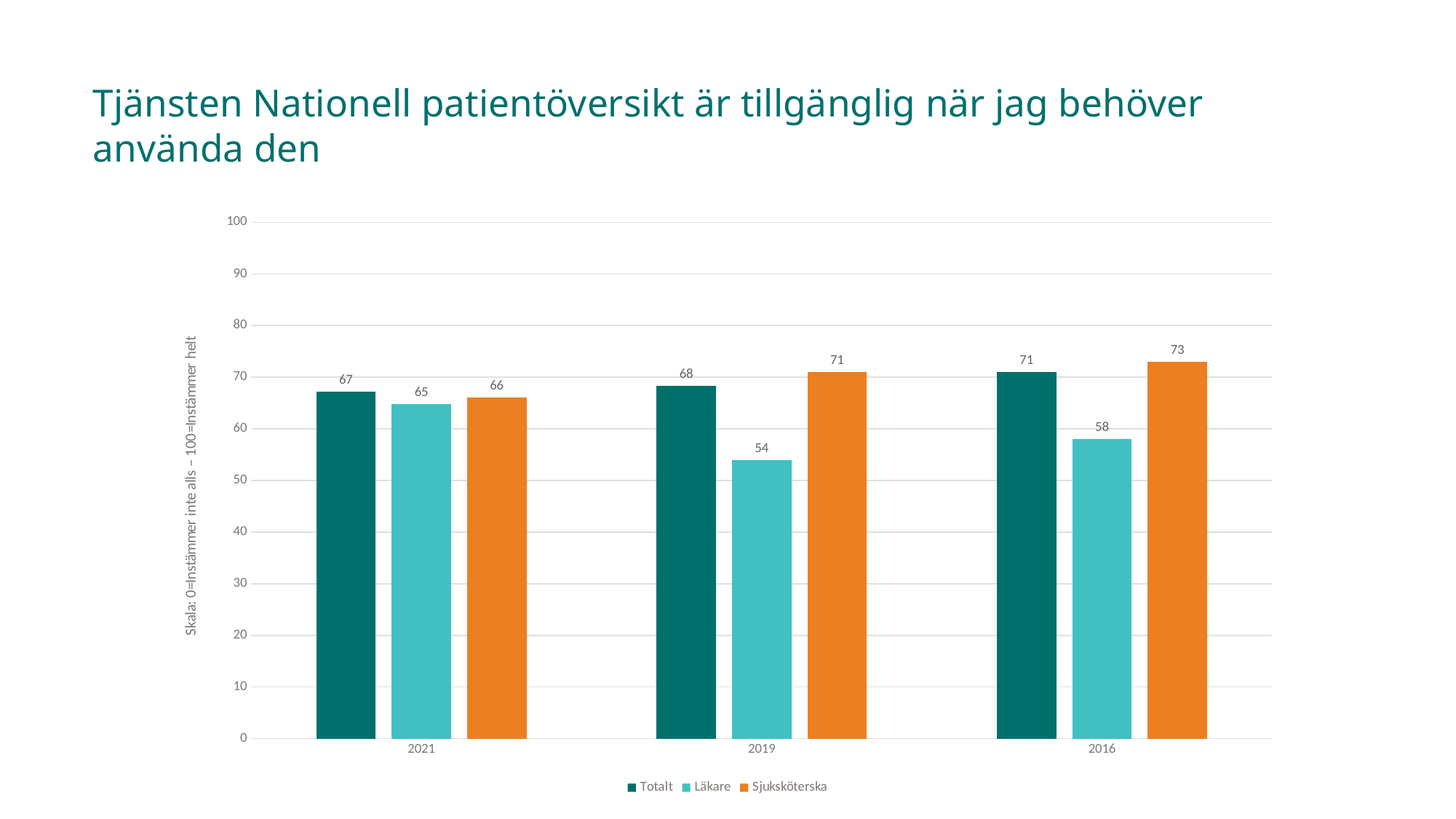
How many series does the legend list? 3 What is the difference between the Sjuksköterska and Läkare values in 2019? 17 What is the value for Totalt in 2021? 67 Which year has the lowest value for Läkare? 2019 What is the value for Sjuksköterska in 2016? 73 What is the value for Läkare in 2019? 54 Which year has the highest value for Sjuksköterska? 2016 Which series is shown in orange in the legend? Sjuksköterska How many years are shown on the x axis? 3 What kind of chart is shown on the slide? bar chart Is the value for Läkare in 2016 greater or less than 60? less Which is larger in 2016, the value for Totalt or the value for Läkare? Totalt